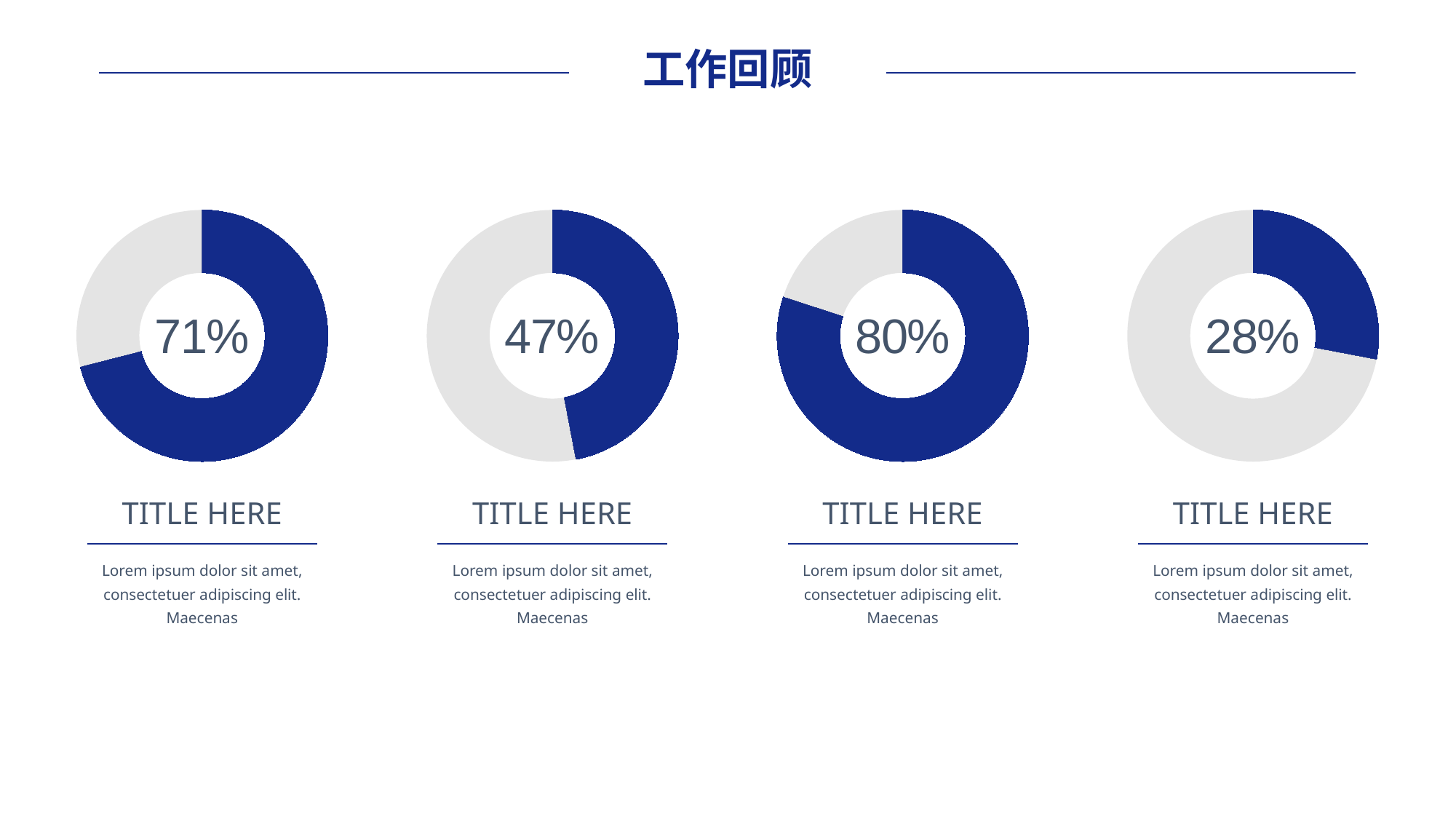
Which of the four donut charts shows the lowest percentage? The rightmost (28%) What percentage is shown in the third donut chart from the left? 80% What percentage is shown in the rightmost donut chart? 28% Which of the four donut charts shows the highest percentage? The third from the left (80%) What percentage is shown in the leftmost donut chart? 71% What percentage is shown in the second donut chart from the left? 47% What kind of chart is used four times on this slide? Donut chart Which is larger: the percentage in the leftmost donut chart or the percentage in the second donut chart from the left? The leftmost (71%) How many donut charts are on the slide? 4 In the third donut chart from the left, what share of the ring is filled in blue? 80% What colour is used for the filled portion of each donut chart? Blue What is the difference between the percentage in the leftmost donut chart and the percentage in the rightmost donut chart? 43%